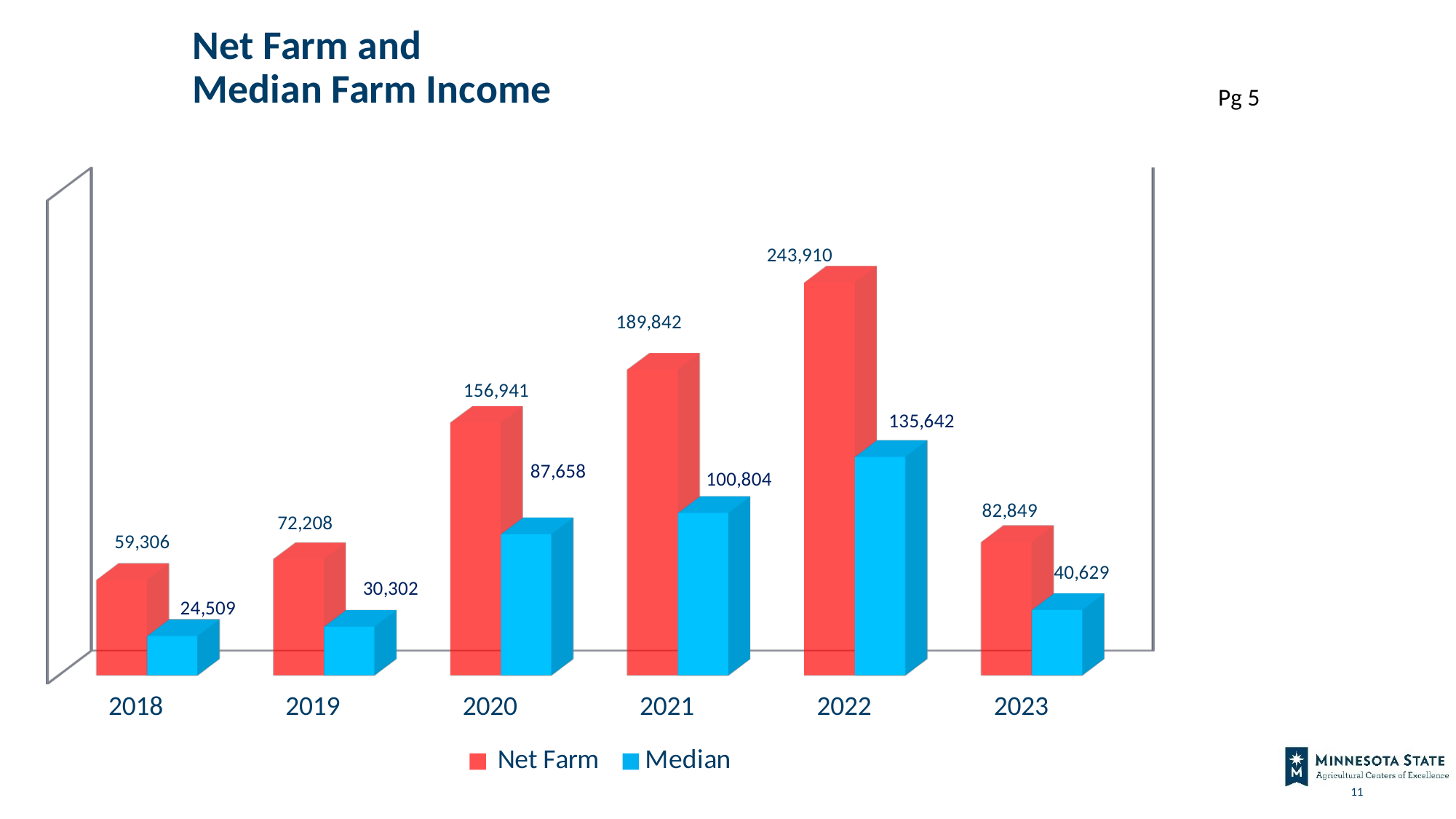
Does the Median income rise or fall from 2018 to 2022? Rise Which is larger, the Net Farm value for 2019 or the Net Farm value for 2023? 2023 What colour represents the Median series in the legend? Blue What is the Median income value for 2018? 24,509 What is the difference between the Net Farm and Median values in 2021? 89,038 Which year has the lowest Median income? 2018 What is the Median income value for 2020? 87,658 Which year has the highest Net Farm income? 2022 What is the Net Farm income value for 2022? 243,910 How many series does the legend list? 2 What kind of chart is shown on the slide? Bar chart How many years are shown on the x axis? 6